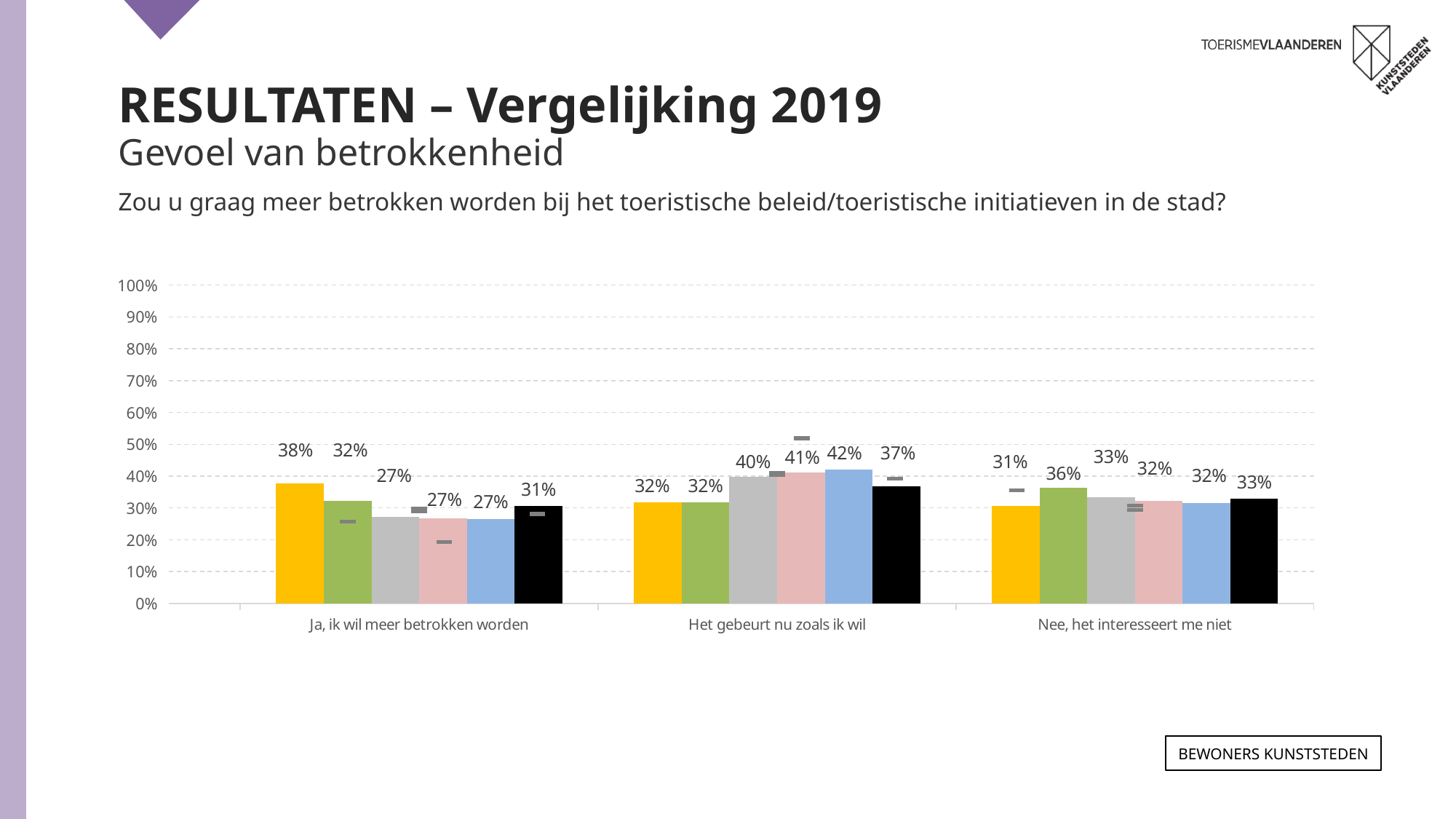
How many answer categories are shown on the x axis? 3 Is the value of the black bar for "Het gebeurt nu zoals ik wil" greater or less than 30%? greater Is the yellow bar larger for "Ja, ik wil meer betrokken worden" or for "Nee, het interesseert me niet"? Ja, ik wil meer betrokken worden What is the lowest value shown in the category "Ja, ik wil meer betrokken worden"? 27% Within the category "Het gebeurt nu zoals ik wil", which coloured bar has the highest value? The blue bar (42%) What is the difference between the blue bar and the yellow bar in "Het gebeurt nu zoals ik wil"? 10 percentage points What is the value of the black bar for "Nee, het interesseert me niet"? 33% What is the value of the green bar for "Nee, het interesseert me niet"? 36% What kind of chart is shown on the slide? Bar chart What is the value of the yellow bar for "Ja, ik wil meer betrokken worden"? 38% What is the difference between the black bar for "Het gebeurt nu zoals ik wil" and the black bar for "Ja, ik wil meer betrokken worden"? 6 percentage points What is the value of the blue bar for "Het gebeurt nu zoals ik wil"? 42%